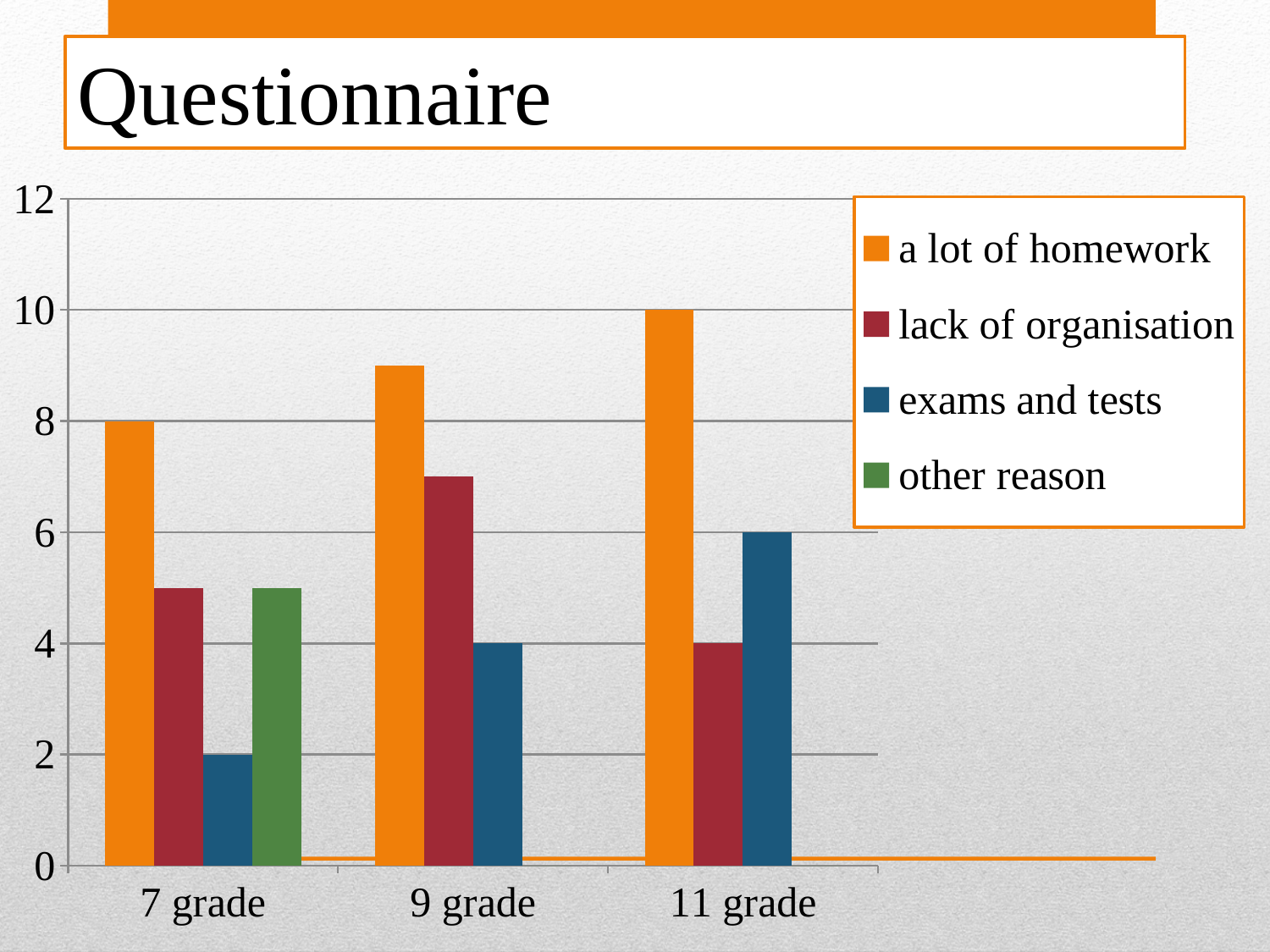
What is the difference between 'a lot of homework' and 'exams and tests' in 11 grade? 4 Which grade has the highest value for 'a lot of homework'? 11 grade What kind of chart is shown on the slide? bar chart How many series does the legend list? 4 What is the value for 'a lot of homework' in 11 grade? 10 What is the value for 'a lot of homework' in 7 grade? 8 How many grade categories are shown on the x axis? 3 Does the value for 'a lot of homework' rise or fall from 7 grade to 11 grade? rise Is the value for 'lack of organisation' in 9 grade greater or less than 6? greater What is the value for 'exams and tests' in 11 grade? 6 What is the value for 'exams and tests' in 7 grade? 2 Which reason has the lowest value in 7 grade? exams and tests